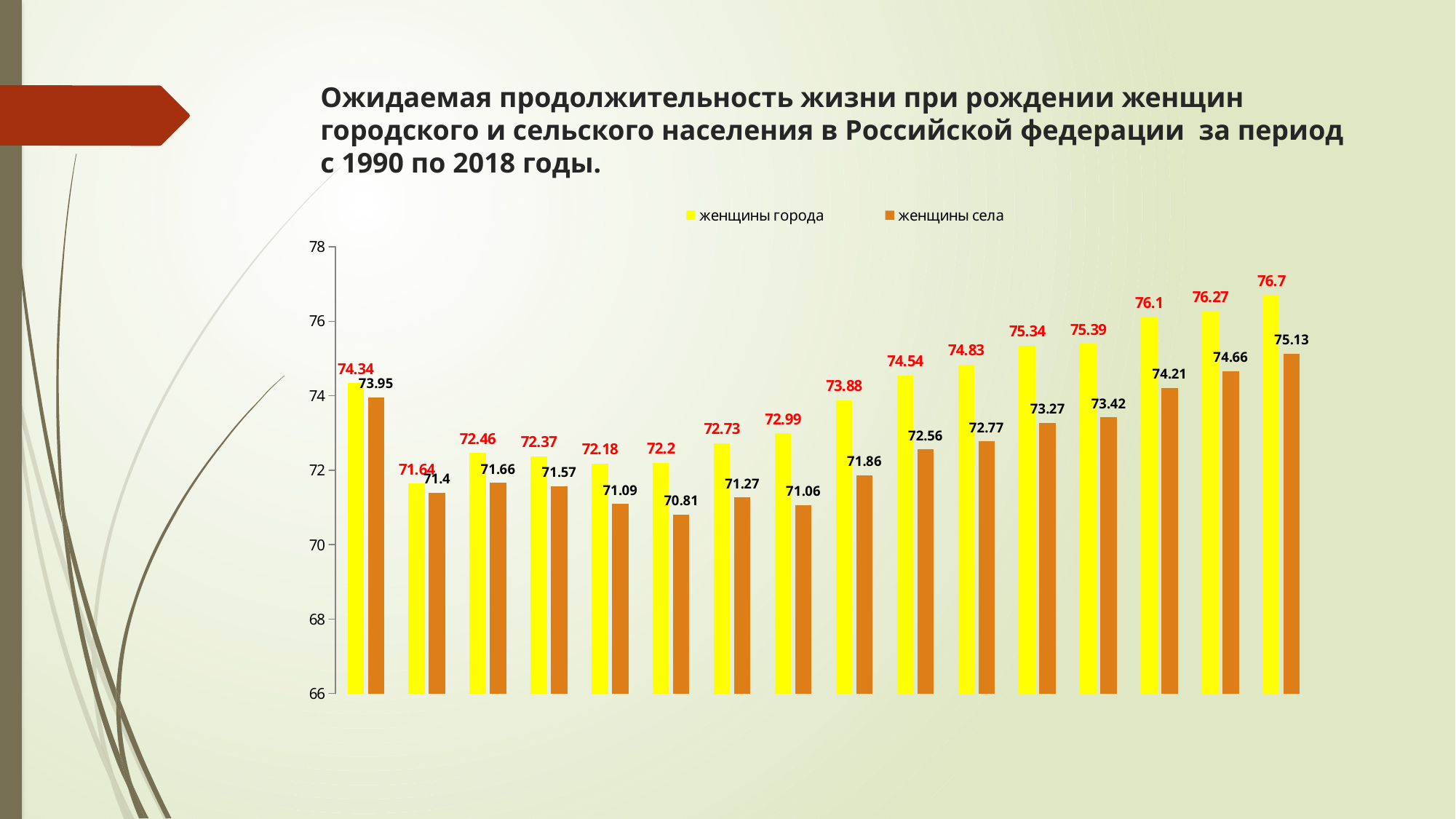
What is the lowest value for the series женщины села? 70.81 Do the values for женщины города rise or fall across the last eight groups of bars from left to right? rise What is the lowest value for the series женщины города? 71.64 In the first group of bars on the left, which series has the larger value, женщины города or женщины села? женщины города What is the highest value for the series женщины города? 76.7 How many series does the legend list? 2 What kind of chart is shown on the slide? bar chart In the last group of bars on the right, what is the difference between женщины города and женщины села? 1.57 What is the value of женщины села in the first group of bars on the left? 73.95 How many groups of bars are plotted in the chart? 16 What are the two series named in the legend? женщины города, женщины села What is the highest value for the series женщины села? 75.13